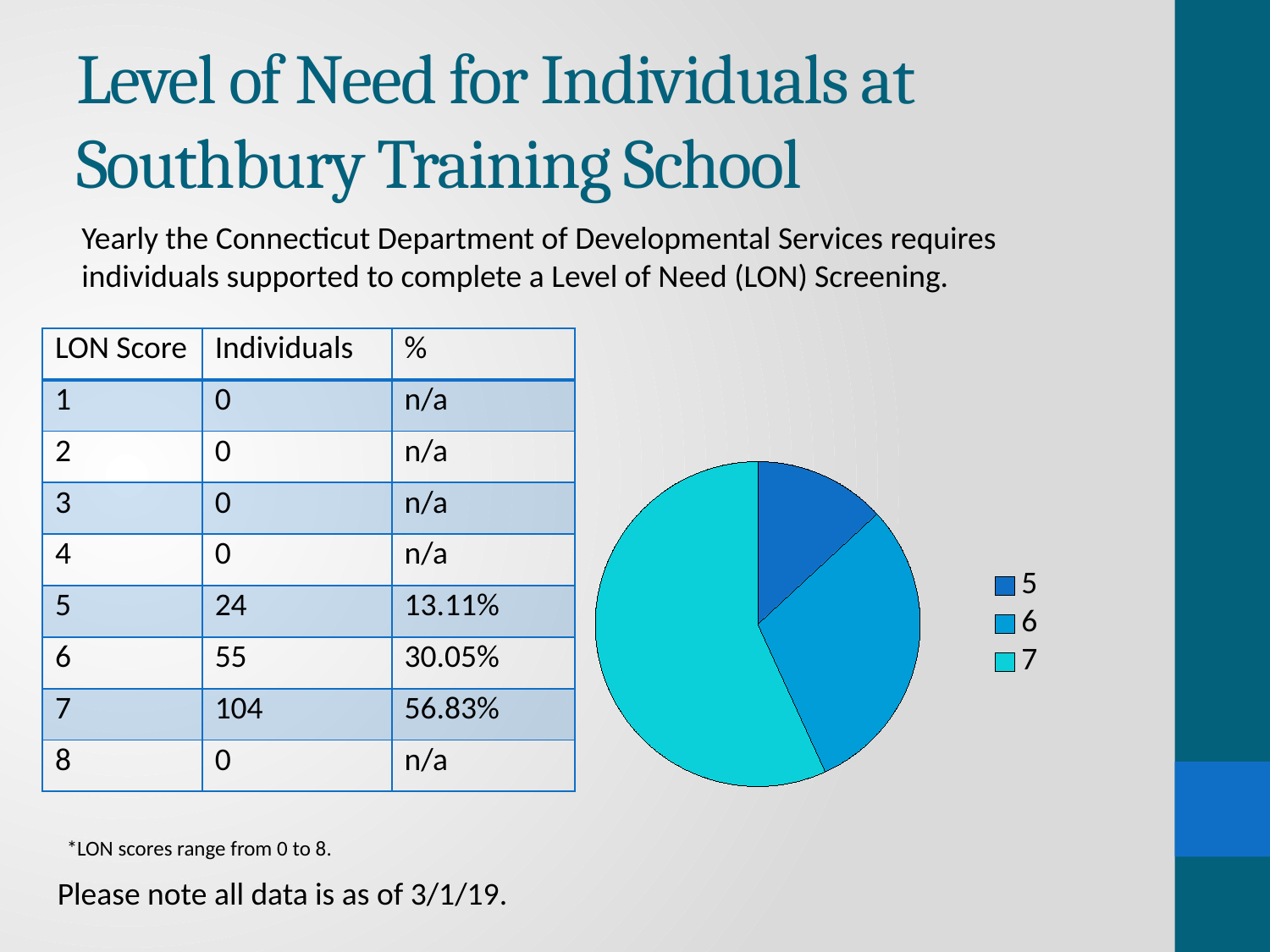
What is the total number of individuals across LON scores 5, 6 and 7? 183 How many entries does the pie chart's legend list? 3 What kind of chart is shown on the slide? pie chart According to the table, how many individuals have a LON score of 7? 104 What share of the pie does LON score 7 represent, as printed in the table? 56.83% What is the difference in the number of individuals between LON score 7 and LON score 6? 49 Is the slice for LON score 6 larger or smaller than the slice for LON score 7? smaller According to the table, what percentage of individuals have a LON score of 6? 30.05% Which legend entry is shown in the lightest (cyan) colour in the pie chart? 7 Which LON score has the smallest slice in the pie chart? 5 According to the table, how many individuals have a LON score of 5? 24 Which LON score has the largest slice in the pie chart? 7